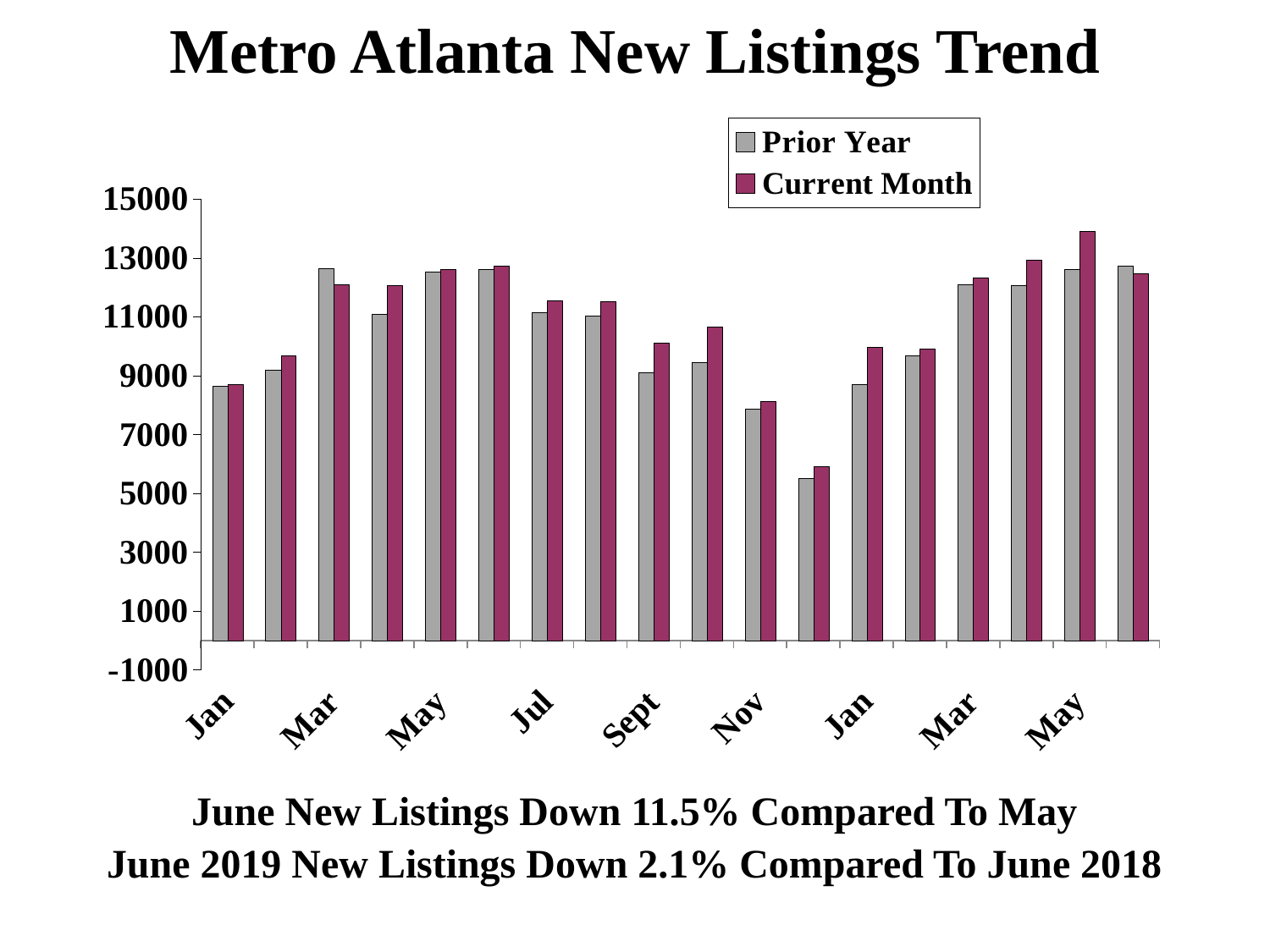
Which month has the highest Current Month value? The second May Is the Prior Year value for the first Mar greater or less than 11000? greater Is the Current Month value for the first Nov greater or less than 9000? less Do the Current Month values rise or fall from Jul to Nov in the first year? Fall Which is larger, the Current Month value for Sept or the Current Month value for the first Nov? Sept Is the Current Month value for the second May greater or less than 13000? greater What kind of chart is shown on the slide? Bar chart What is the title of the chart? Metro Atlanta New Listings Trend What are the two series named in the legend? Prior Year and Current Month How many series does the legend list? 2 How many months (pairs of bars) are plotted on the chart? 18